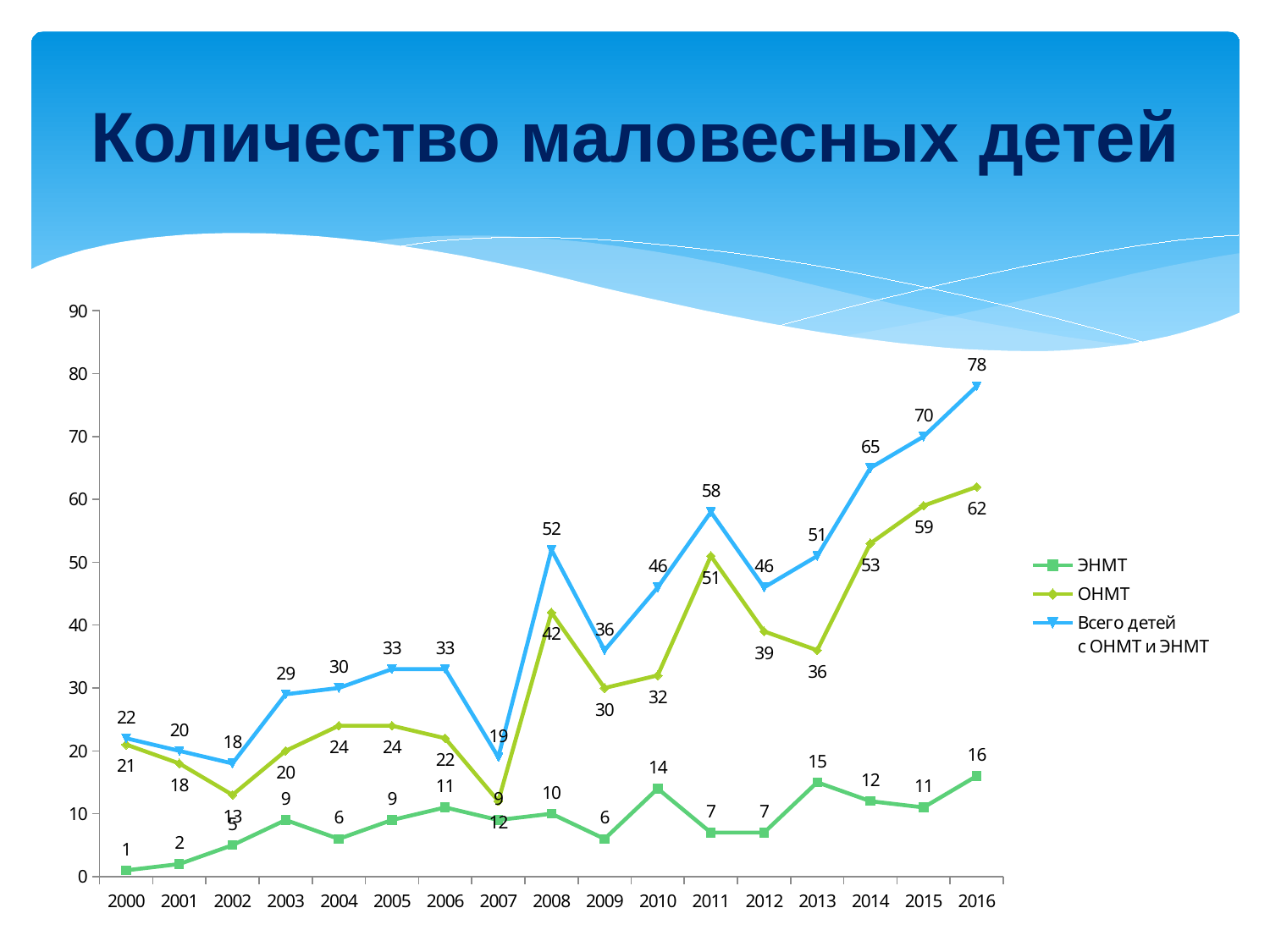
What is the value of the ЭНМТ series in 2013? 15 What is the value of the series 'Всего детей с ОНМТ и ЭНМТ' in 2016? 78 What is the difference between the 'Всего детей с ОНМТ и ЭНМТ' values in 2016 and 2015? 8 Does the 'Всего детей с ОНМТ и ЭНМТ' series generally rise or fall from 2013 to 2016? rise In which year does the ЭНМТ series reach its highest value? 2016 What is the title of the slide? Количество маловесных детей In which year is the 'Всего детей с ОНМТ и ЭНМТ' series lowest? 2002 How many series does the legend list? 3 How many years are shown on the x axis? 17 What type of chart is shown on the slide? line chart Which is larger: the ОНМТ value in 2008 or the ОНМТ value in 2012? 2008 What is the value of the ОНМТ series in 2011? 51